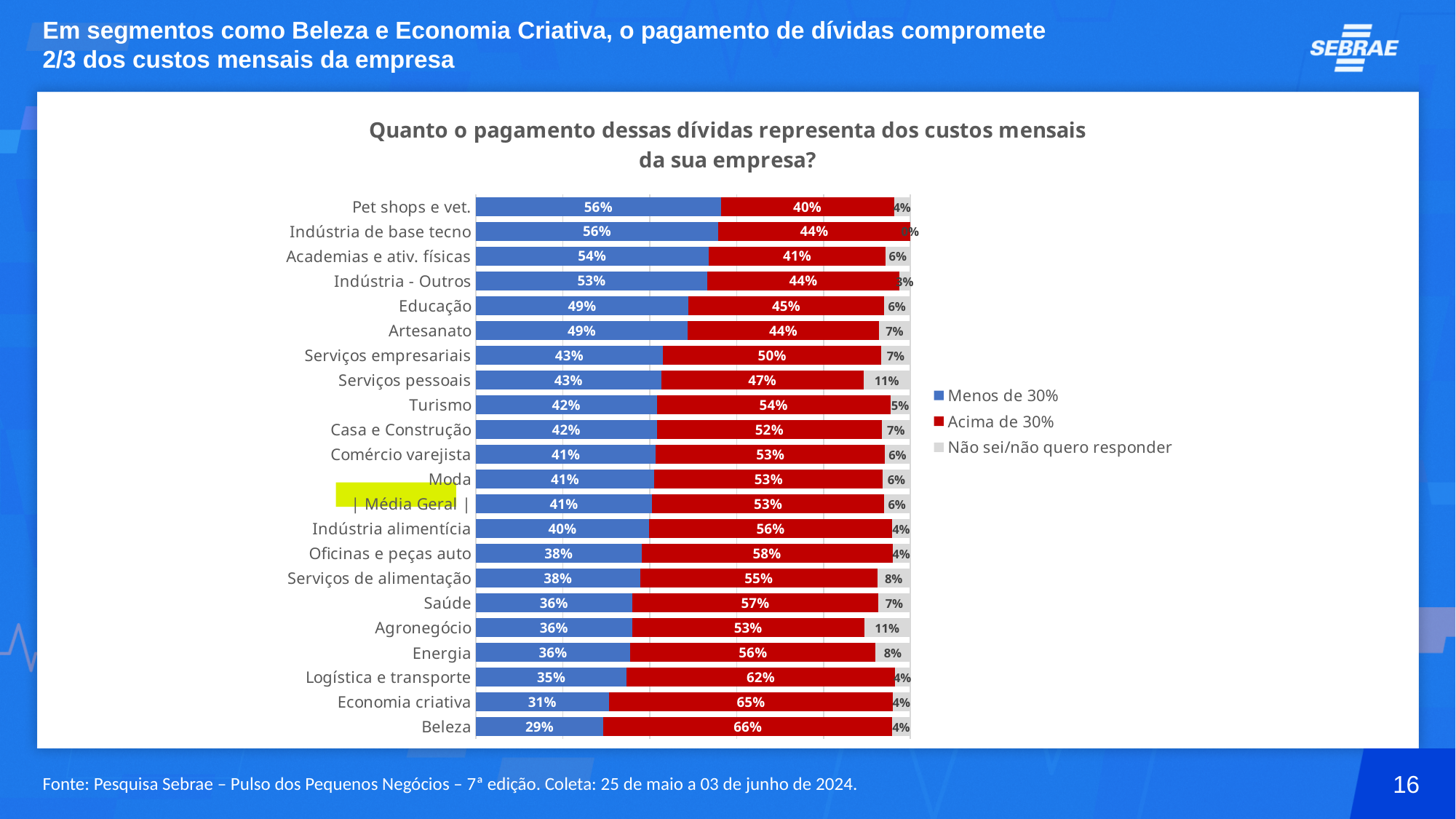
What is the "Menos de 30%" value for Economia criativa? 31% What kind of chart is shown on the slide? Stacked bar chart What percentage of Beleza businesses answered "Acima de 30%"? 66% How many segment rows (including Média Geral) are shown in the chart? 22 What is the "Acima de 30%" value for the Média Geral row? 53% Which has a larger "Acima de 30%" value, Turismo or Casa e Construção? Turismo For Beleza, how many percentage points higher is "Acima de 30%" than "Menos de 30%"? 37 percentage points What is the "Não sei/não quero responder" value for Serviços pessoais? 11% What is the total of the three values shown for Educação? 100% How many series does the legend list? 3 Which segment has the highest "Acima de 30%" value? Beleza Which segment has the lowest "Menos de 30%" value? Beleza